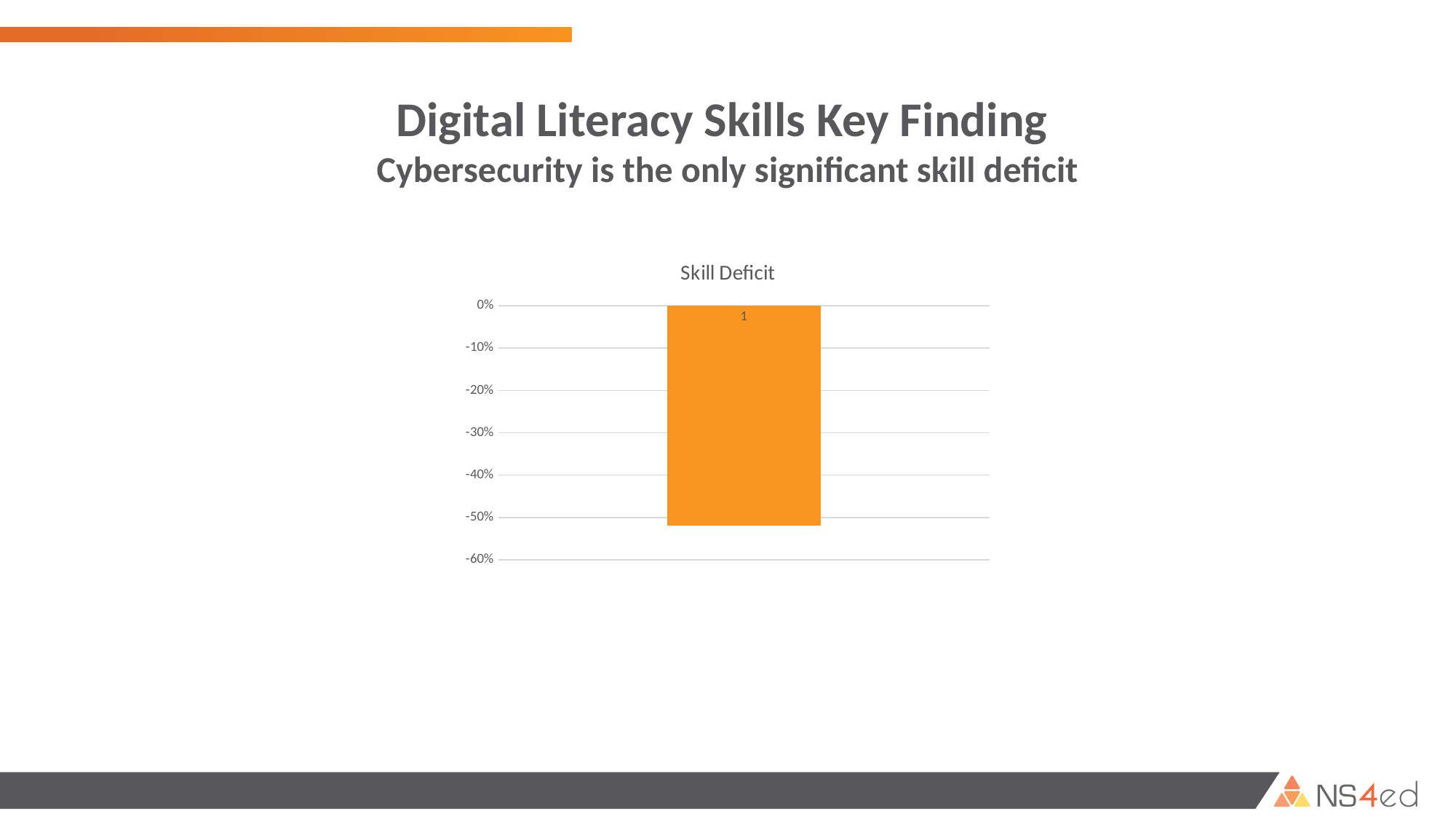
Is the value of the bar in the Skill Deficit chart greater or less than -60%? greater Is the value of the bar in the Skill Deficit chart greater or less than -40%? less What is the title of the chart? Skill Deficit Is the value of the bar in the Skill Deficit chart greater or less than -20%? less What is the lowest value shown on the vertical axis of the Skill Deficit chart? -60% What category label appears on the single bar in the Skill Deficit chart? 1 What kind of chart is shown on the slide? bar chart How many bars does the Skill Deficit chart contain? 1